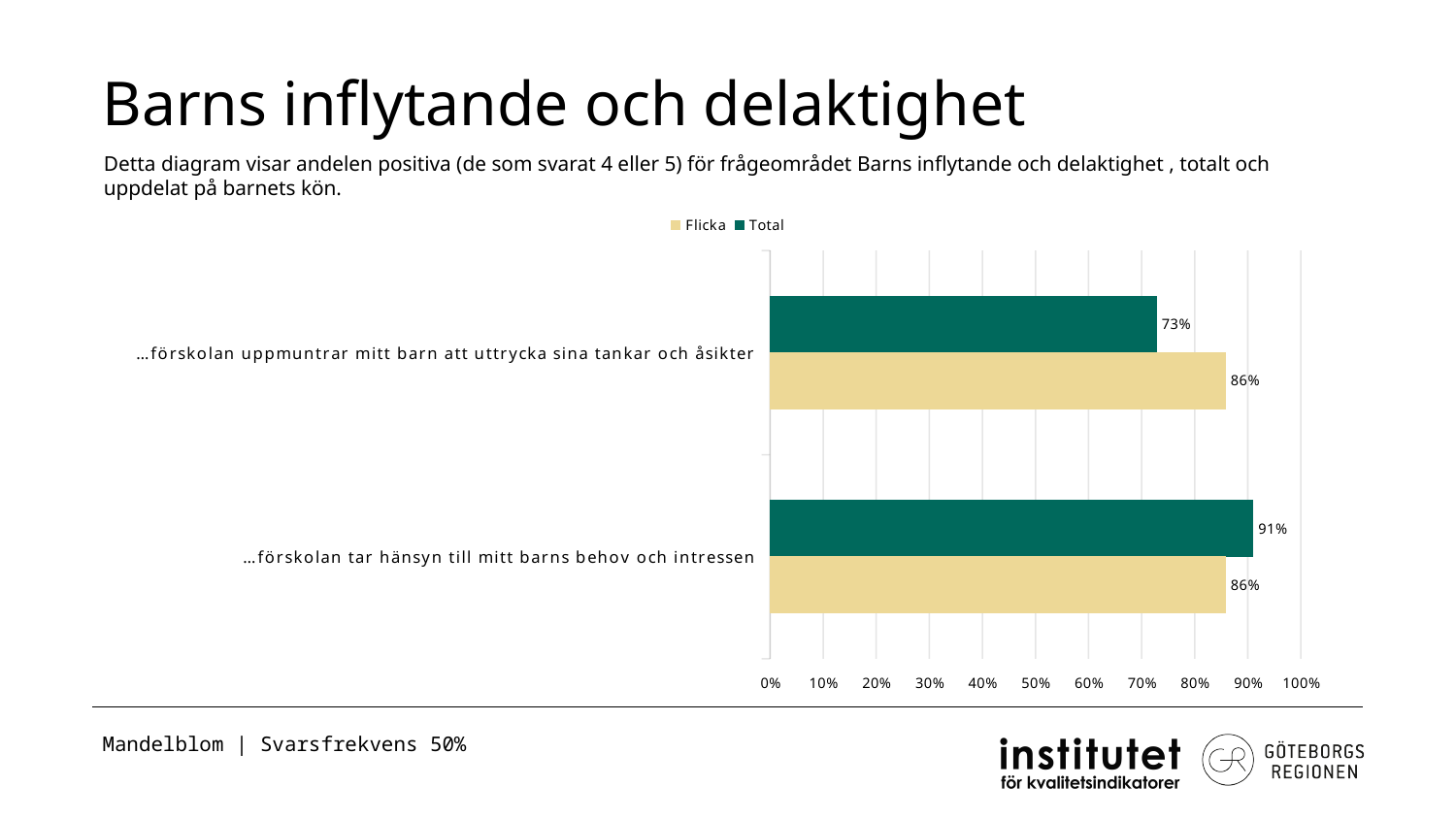
Which category has the highest Total value? …förskolan tar hänsyn till mitt barns behov och intressen What is the Total value for "…förskolan tar hänsyn till mitt barns behov och intressen"? 91% What is the Total value for "…förskolan uppmuntrar mitt barn att uttrycka sina tankar och åsikter"? 73% What kind of chart is shown on the slide? Bar chart Which category has the lowest Total value? …förskolan uppmuntrar mitt barn att uttrycka sina tankar och åsikter What is the difference between the Flicka and Total values for "…förskolan uppmuntrar mitt barn att uttrycka sina tankar och åsikter"? 13% How many categories are shown on the chart? 2 For "…förskolan tar hänsyn till mitt barns behov och intressen", which is larger, the Flicka value or the Total value? Total What is the difference between the Total and Flicka values for "…förskolan tar hänsyn till mitt barns behov och intressen"? 5% What is the Flicka value for "…förskolan tar hänsyn till mitt barns behov och intressen"? 86% How many series does the legend list? 2 What is the Flicka value for "…förskolan uppmuntrar mitt barn att uttrycka sina tankar och åsikter"? 86%